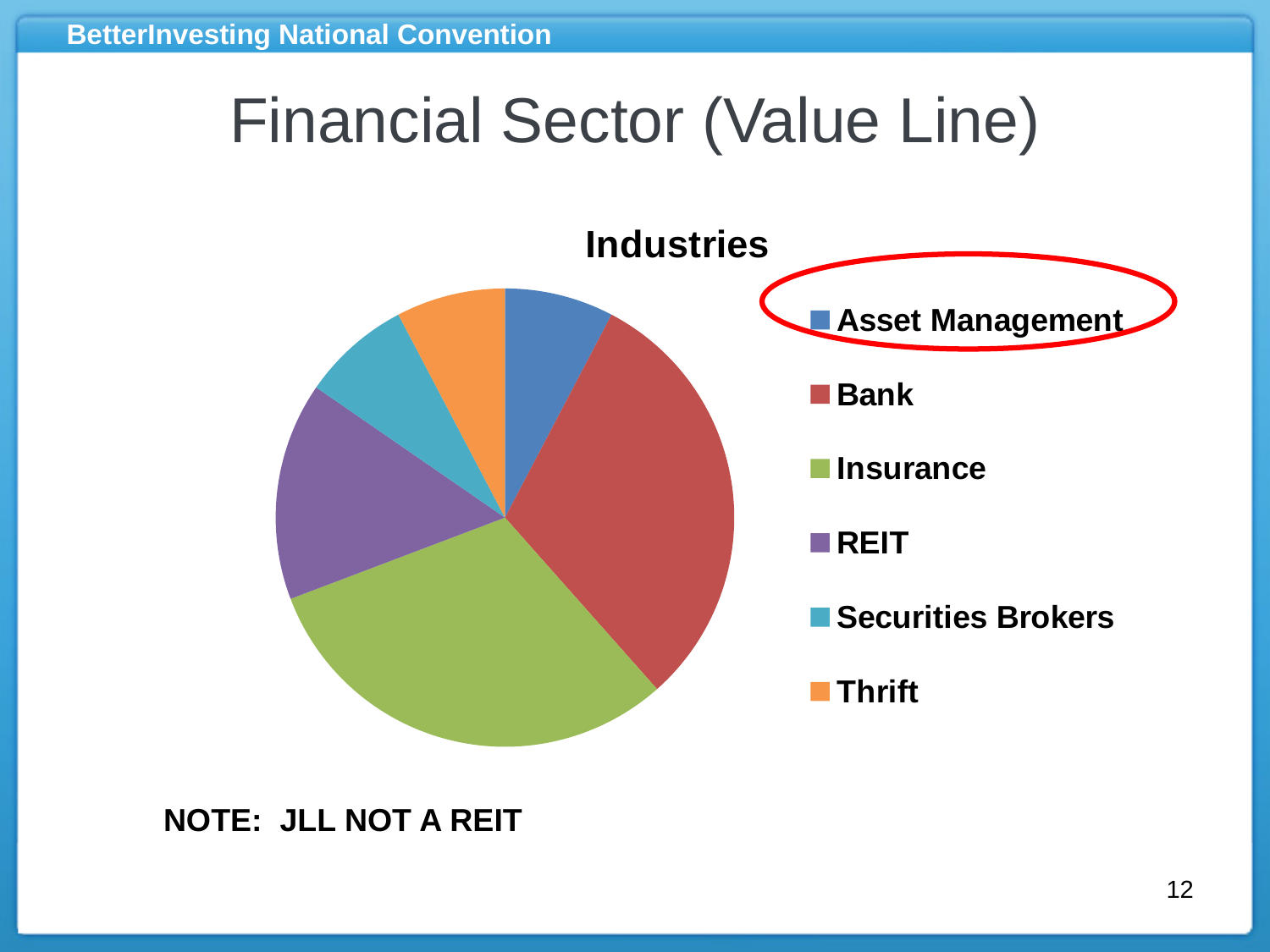
What kind of chart is shown on the slide? pie chart How many entries does the legend of the pie chart list? 6 Which slice is larger, REIT or Thrift? REIT Which slice is larger, Asset Management or Bank? Bank Which slice is larger, Insurance or Securities Brokers? Insurance What is the title of the pie chart? Industries Which legend entry is circled in red? Asset Management How many slices does the pie chart have? 6